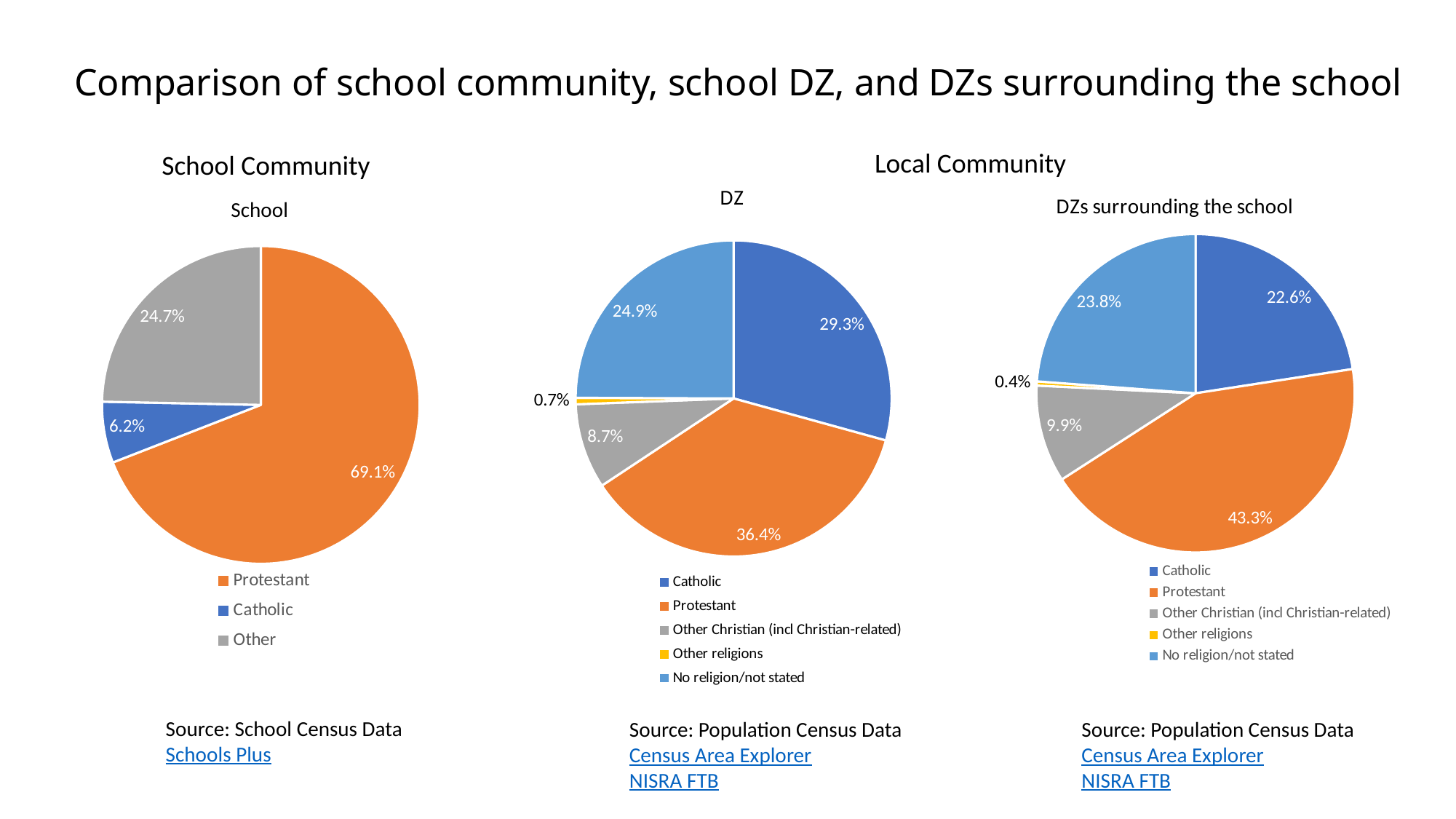
What kind of chart is the DZs surrounding the school chart? Pie chart In the DZs surrounding the school pie chart, what share is Other religions? 0.4% How many slices does the School pie chart have? 3 In the School pie chart, what share is Protestant? 69.1% In the School pie chart, what colour is the Other slice? Grey In the DZ pie chart, what share is No religion/not stated? 24.9% How many entries does the legend of the DZ pie chart list? 5 In the DZ pie chart, what is the difference between the Protestant and Catholic shares? 7.1% In the School pie chart, what share is Catholic? 6.2% In the DZs surrounding the school pie chart, which category has the smallest share? Other religions In the DZ pie chart, which category has the largest share? Protestant In the DZs surrounding the school pie chart, which is larger: Catholic or No religion/not stated? No religion/not stated